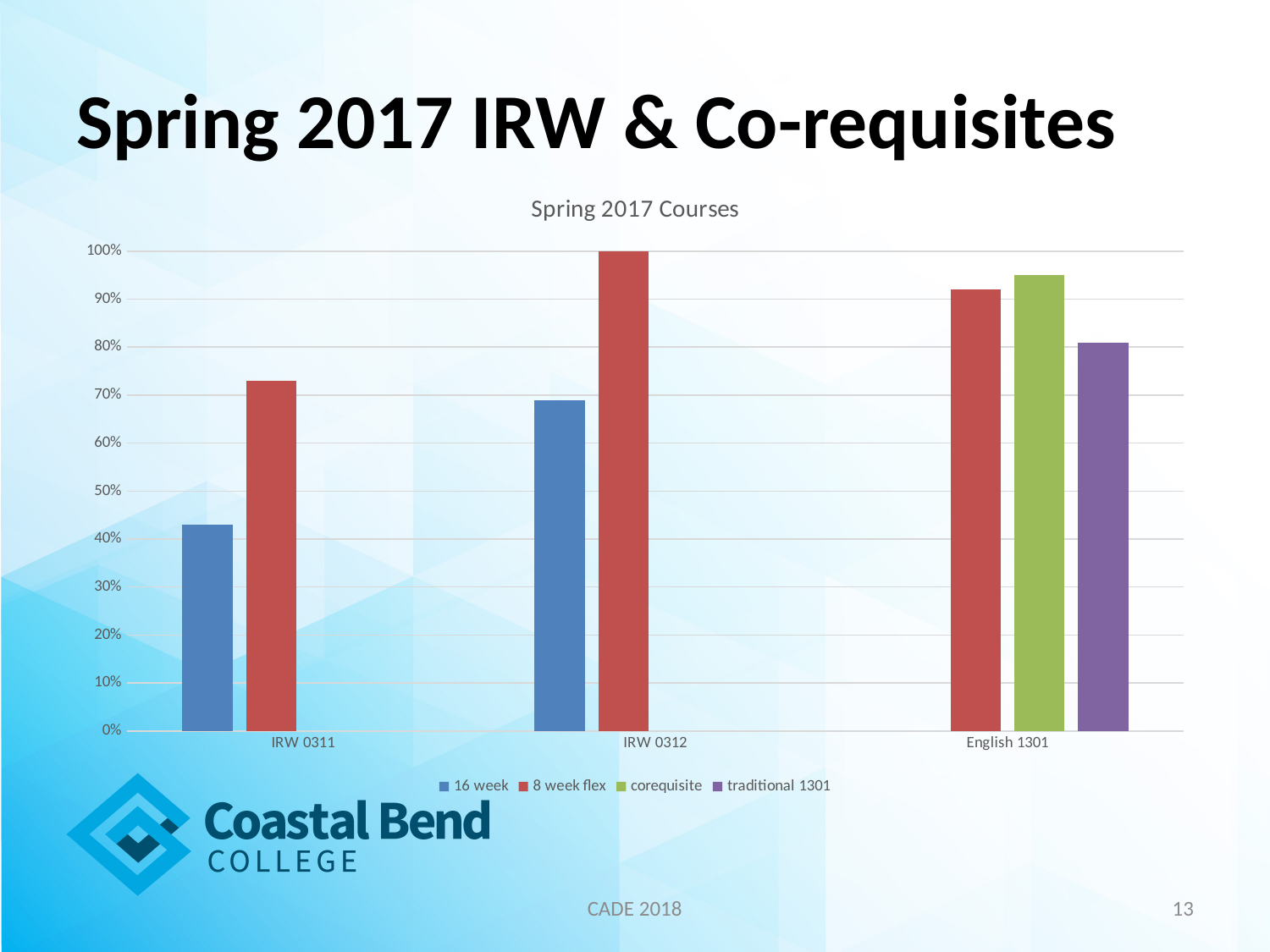
Which course has the highest 8 week flex value? IRW 0312 What type of chart is shown on the slide? bar chart How many course categories are shown on the x axis? 3 What is the title of the chart? Spring 2017 Courses Is the value for 8 week flex in IRW 0311 greater or less than 70%? greater Is the value for traditional 1301 in English 1301 greater or less than 90%? less What is the value for 8 week flex in IRW 0312? 100% Which course has the lowest 16 week value? IRW 0311 In English 1301, which is larger: the corequisite value or the traditional 1301 value? corequisite How many series does the legend list? 4 Is the value for 16 week in IRW 0311 greater or less than 50%? less In IRW 0312, which is larger: the 16 week value or the 8 week flex value? 8 week flex